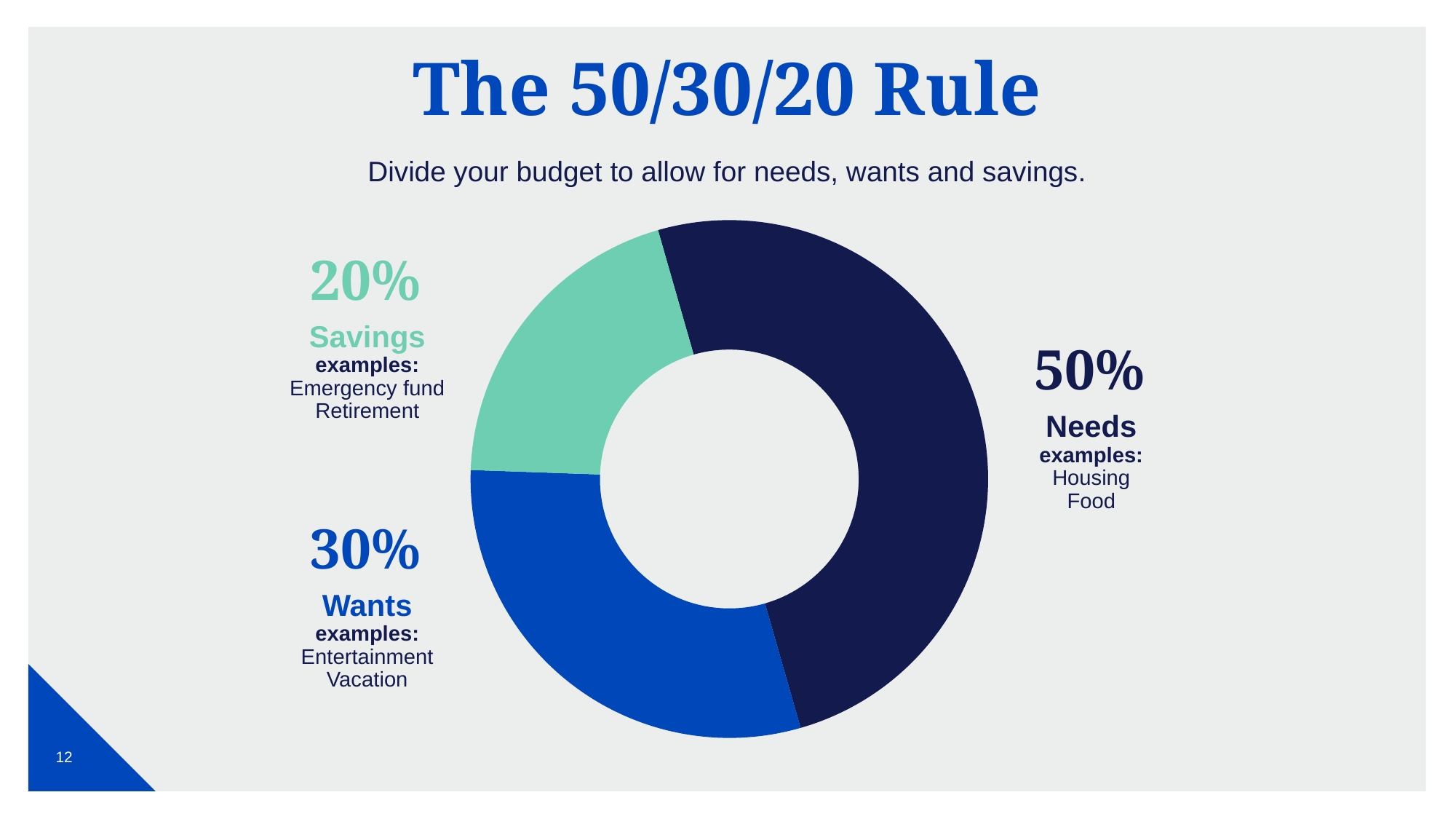
Which category has the largest share of the chart? Needs What is the difference between the Needs share and the Wants share? 20% What is the difference between the Wants share and the Savings share? 10% What share of the budget does the chart allocate to Wants? 30% How many categories does the chart show? 3 Which category has the smallest share of the chart? Savings What share of the budget does the chart allocate to Needs? 50% What share of the budget does the chart allocate to Savings? 20% What kind of chart is shown on the slide? Doughnut (pie) chart What is the title of the slide containing the chart? The 50/30/20 Rule What colour is the Savings slice of the chart? Light green Which is larger, the share for Wants or the share for Savings? Wants